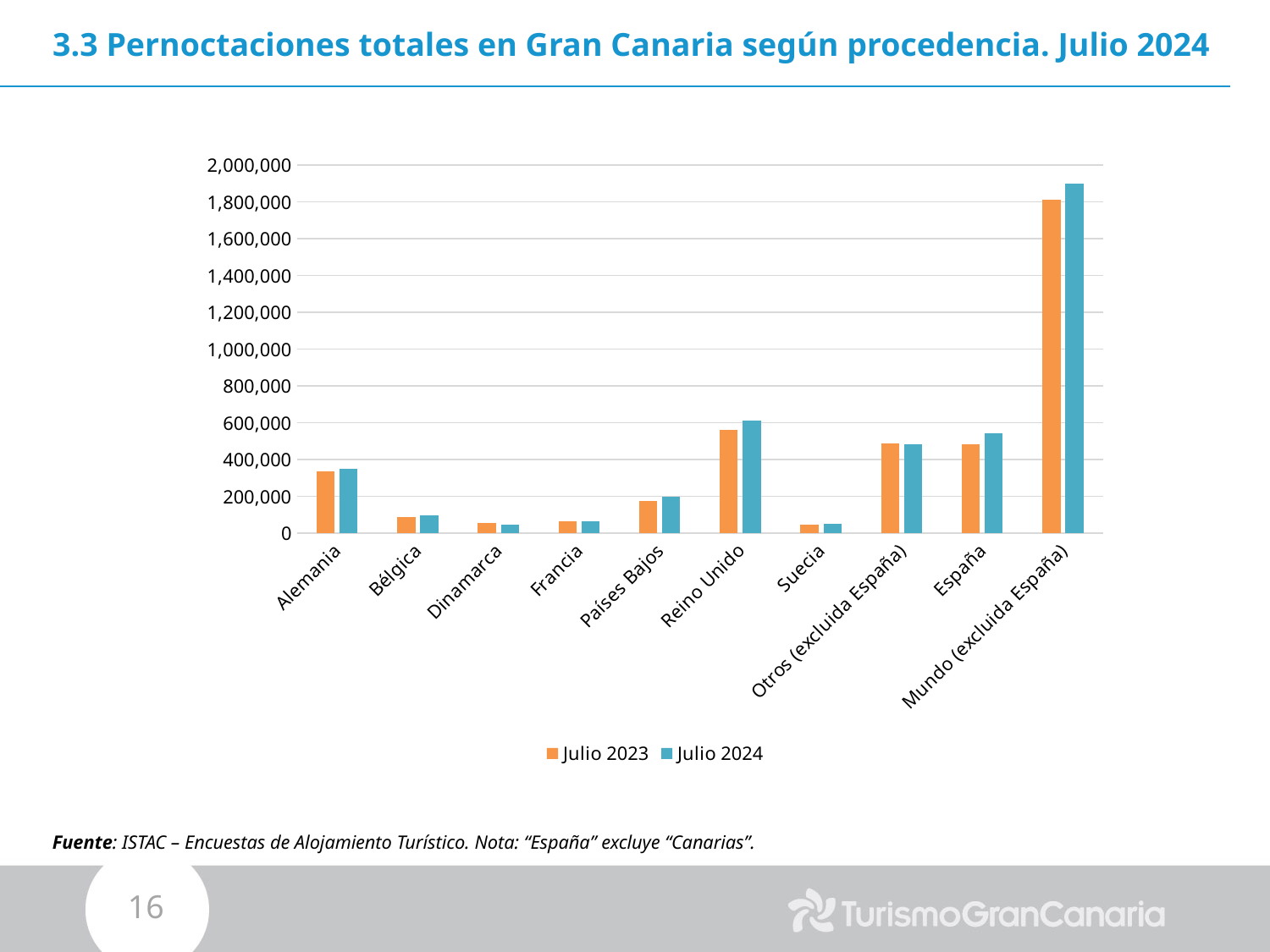
How many series does the legend list? 2 Is the Julio 2024 value for España greater or less than 400,000? greater Is the Julio 2023 value for Reino Unido greater or less than 600,000? less Which category has the highest value for Julio 2023? Mundo (excluida España) For Reino Unido, which is larger: Julio 2023 or Julio 2024? Julio 2024 Is the Julio 2024 value for Mundo (excluida España) greater or less than 1,800,000? greater Which category has the highest value for Julio 2024? Mundo (excluida España) For Julio 2024, which is larger: Países Bajos or Bélgica? Países Bajos What kind of chart is shown on the slide? bar chart How many origin categories are shown on the x axis? 10 What are the two series named in the legend? Julio 2023 and Julio 2024